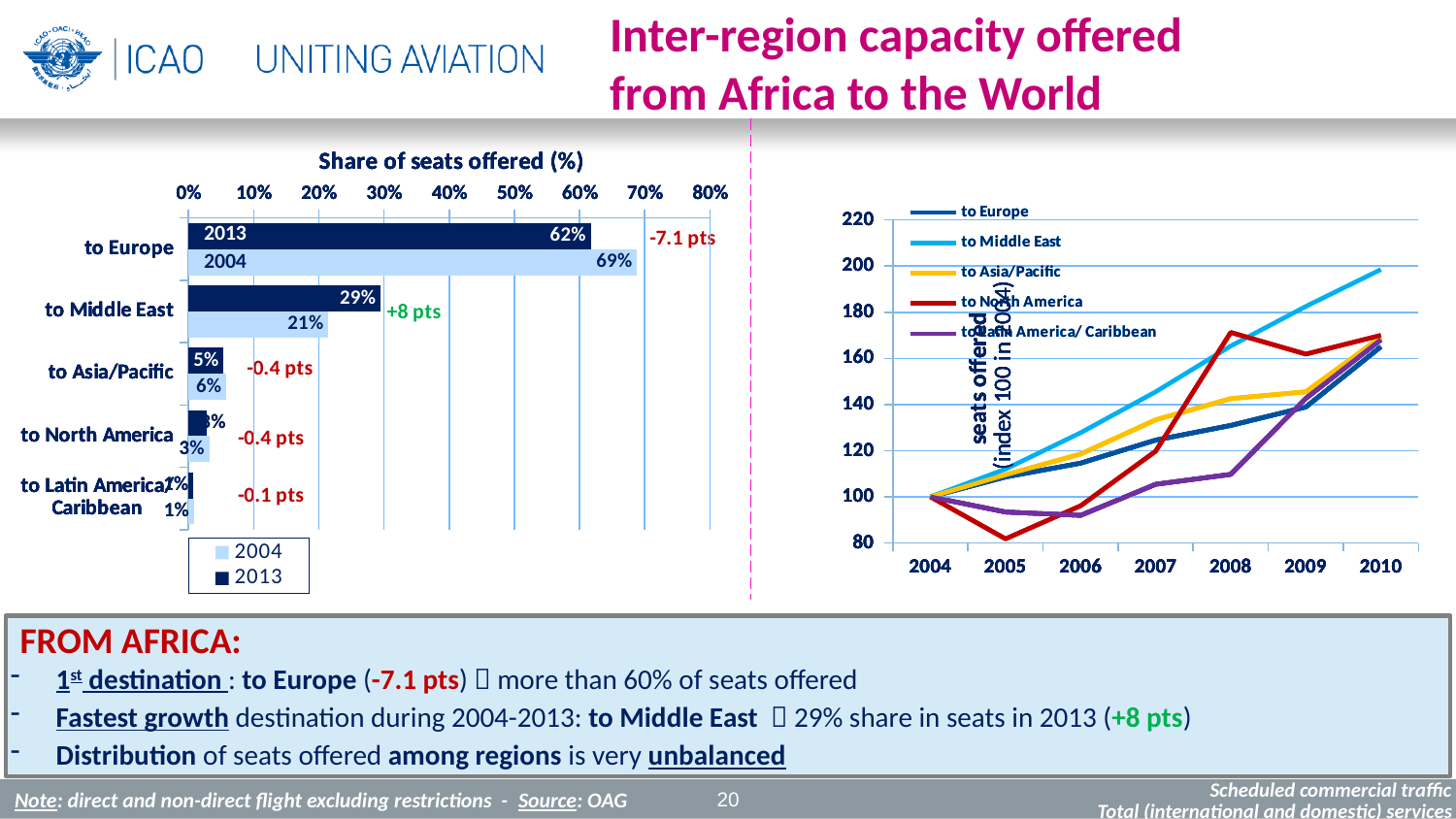
In the line chart on the right, which series has the highest value in 2010? to Middle East In the 'Share of seats offered (%)' bar chart, what is the 2013 share for 'to Europe'? 62% In the line chart on the right, is the value for 'to North America' in 2005 greater or less than 100? less In the 'Share of seats offered (%)' bar chart, which is larger: the 2013 share for 'to Middle East' or the 2013 share for 'to Asia/Pacific'? to Middle East What kind of chart is the chart on the left of the slide? Bar chart In the 'Share of seats offered (%)' bar chart, what is the difference between the 2004 and 2013 shares for 'to Europe'? -7.1 pts In the line chart on the right, is the value for 'to Middle East' in 2010 greater or less than 180? greater In the 'Share of seats offered (%)' bar chart, which destination has the highest share in 2013? to Europe In the 'Share of seats offered (%)' bar chart, how many series does the legend list? 2 In the line chart on the right, how many series does the legend list? 5 In the 'Share of seats offered (%)' bar chart, what is the 2004 share for 'to Middle East'? 21% In the 'Share of seats offered (%)' bar chart, how many destination categories are shown? 5